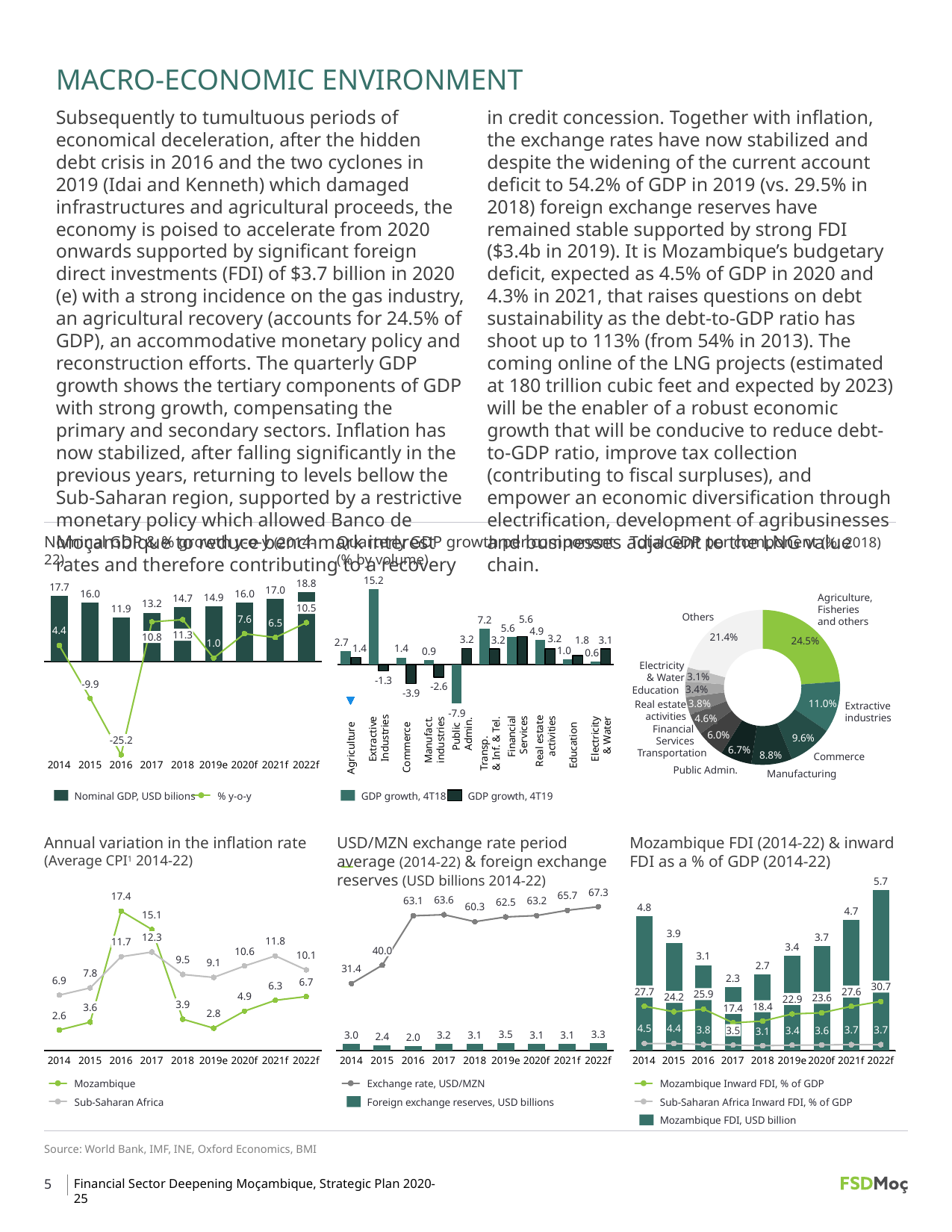
In the top-left chart (Nominal GDP & % growth), which year has the lowest % y-o-y growth? 2016 In the 'Annual variation in the inflation rate' chart, which is larger in 2014: Mozambique or Sub-Saharan Africa? Sub-Saharan Africa In the top-middle chart (quarterly GDP growth by industry), what is the GDP growth 4T18 value for Extractive Industries? 15.2 In the 'Mozambique FDI (2014-22)' chart, which year has the highest Mozambique FDI in USD billion? 2022f In the top-right donut chart (Total GDP per industry), how many slices are shown? 11 In the top-right donut chart (Total GDP per industry), what share does Agriculture, Fisheries and others have? 24.5% In the top-left chart (Nominal GDP & % growth), what is the nominal GDP value for 2022f? 18.8 In the 'Annual variation in the inflation rate' chart, what is the Mozambique value for 2016? 17.4 In the top-middle chart (quarterly GDP growth by industry), which industry has the lowest GDP growth 4T18 value? Public Admin. In the 'USD/MZN exchange rate' chart, what is the foreign exchange reserves value for 2016? 2.0 In the 'Mozambique FDI (2014-22)' chart, how many series does the legend list? 3 In the top-left chart (Nominal GDP & % growth), what is the difference between the nominal GDP values for 2022f and 2016? 6.9